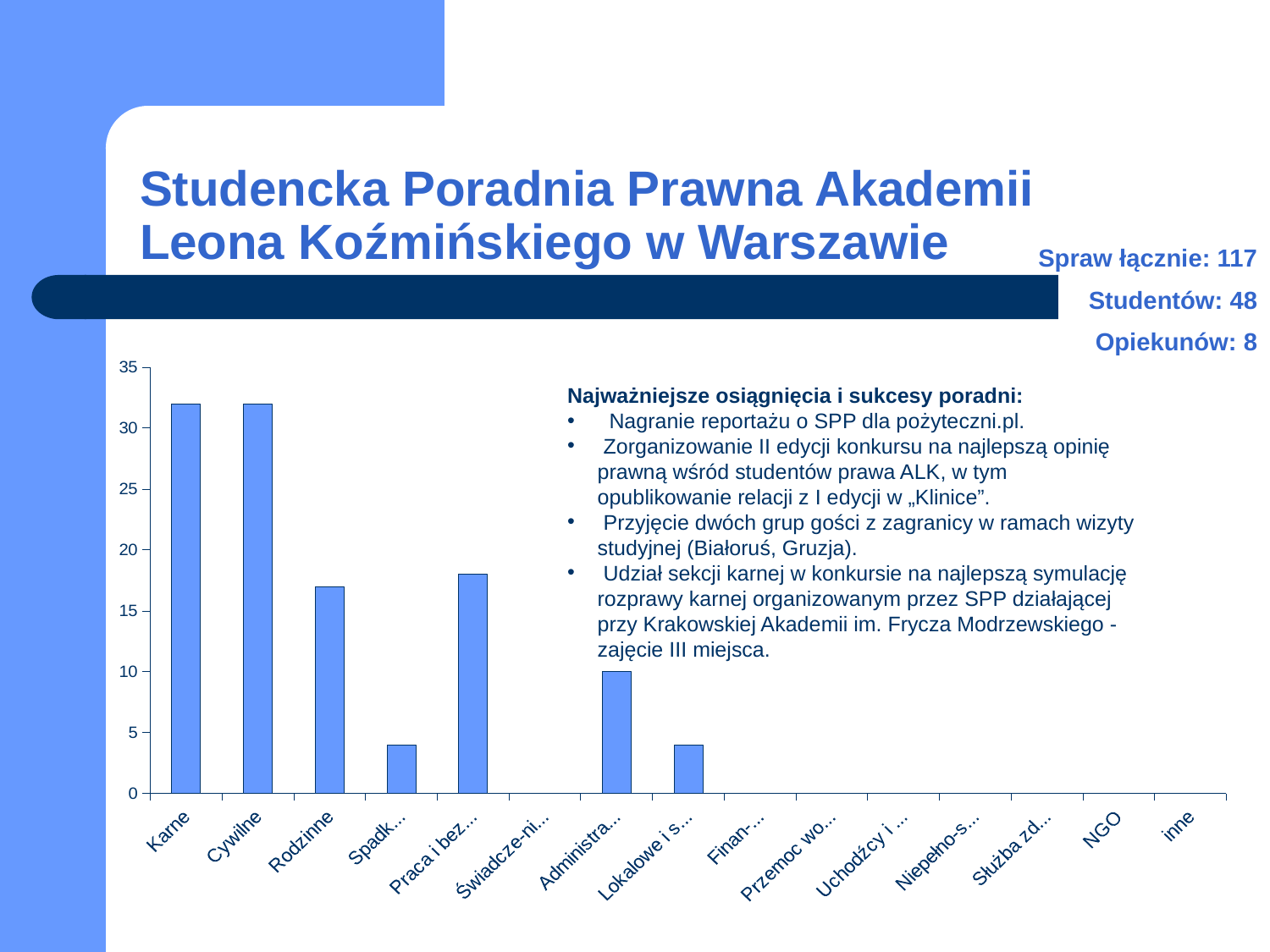
Is the value for Karne greater or less than 30? greater What kind of chart is shown on the slide? bar chart Which has the larger value, Karne or Rodzinne? Karne Which has the larger value, Praca i bez... or Lokalowe i s...? Praca i bez... Is the value for Spadk... greater or less than 5? less What colour are the bars in the chart? blue Is the value for NGO greater or less than 5? less How many categories are shown on the x axis of the chart? 15 Which has the larger value, Administra... or Spadk...? Administra...